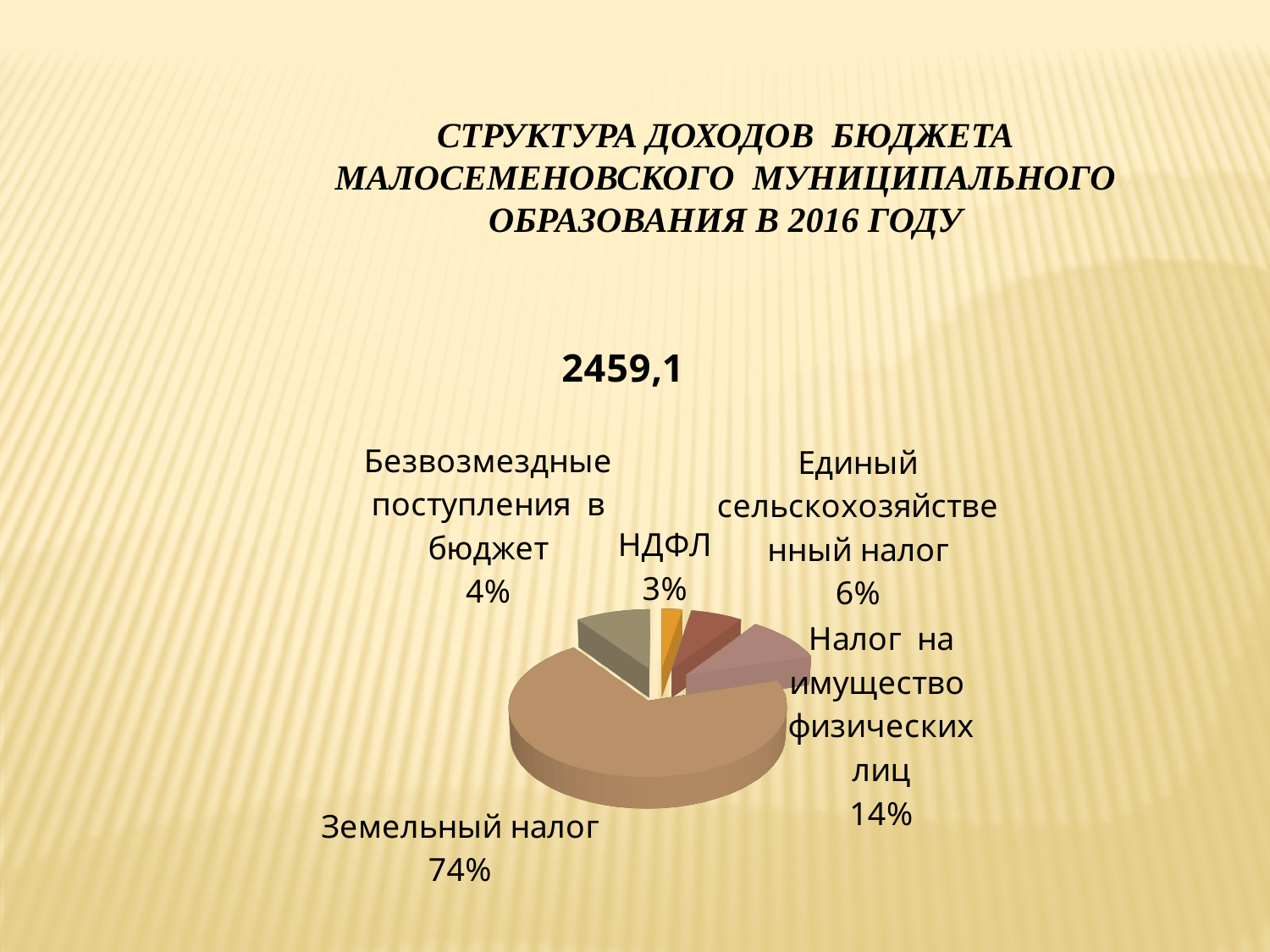
Which is larger, the share for Единый сельскохозяйственный налог or the share for Безвозмездные поступления в бюджет? Единый сельскохозяйственный налог What share of the pie does Единый сельскохозяйственный налог have? 6% What is the title shown above the pie chart? 2459,1 What kind of chart is shown on the slide? pie chart Which slice of the pie is the smallest? НДФЛ What share of the pie does Безвозмездные поступления в бюджет have? 4% What share of the pie does Земельный налог have? 74% How many slices does the pie chart have? 5 What share of the pie does НДФЛ have? 3% What is the difference in percentage points between Земельный налог and Налог на имущество физических лиц? 60 What share of the pie does Налог на имущество физических лиц have? 14% Which slice of the pie is the largest? Земельный налог